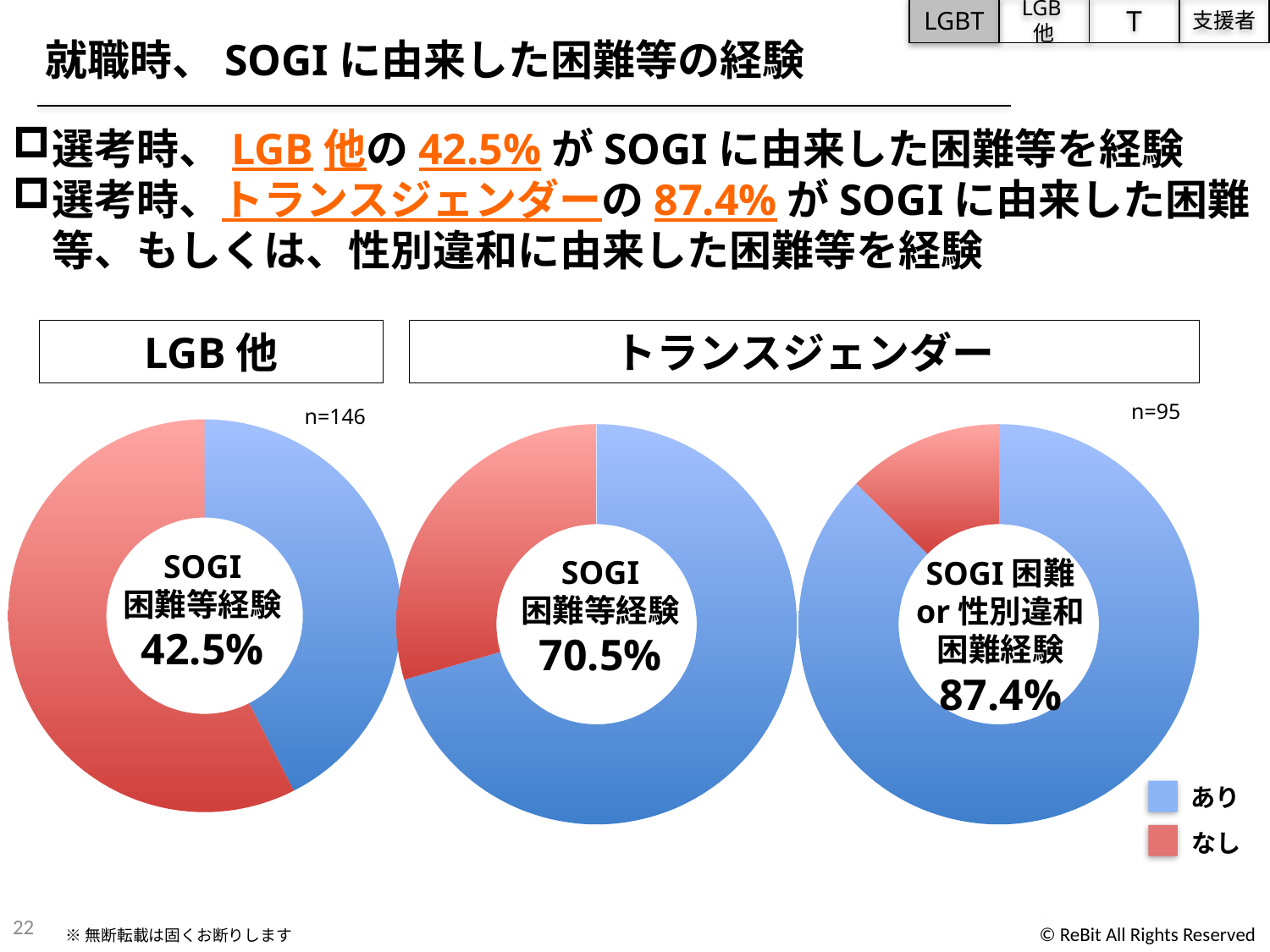
How many slices does each donut chart have? 2 What is the difference between the percentage in the right chart (87.4%) and the percentage in the middle chart (70.5%)? 16.9 percentage points In the left chart (LGB他), which slice is larger, あり or なし? なし In the right chart (SOGI困難 or 性別違和困難経験), which slice is larger, あり or なし? あり In the left chart (LGB他), what share of the pie does the なし slice represent? 57.5% What is the difference between the percentage in the right chart (87.4%) and the percentage in the left chart (42.5%)? 44.9 percentage points In the right chart (トランスジェンダー, SOGI困難 or 性別違和困難経験), what percentage is shown in the centre? 87.4% In the middle chart (トランスジェンダー, SOGI困難等経験), what percentage is shown in the centre? 70.5% In the left chart (LGB他), what percentage is shown for SOGI困難等経験? 42.5% What kind of chart is used for the three charts on the slide? Donut (pie) chart What is the sample size (n) shown for the LGB他 chart? n=146 How many entries does the legend list? 2